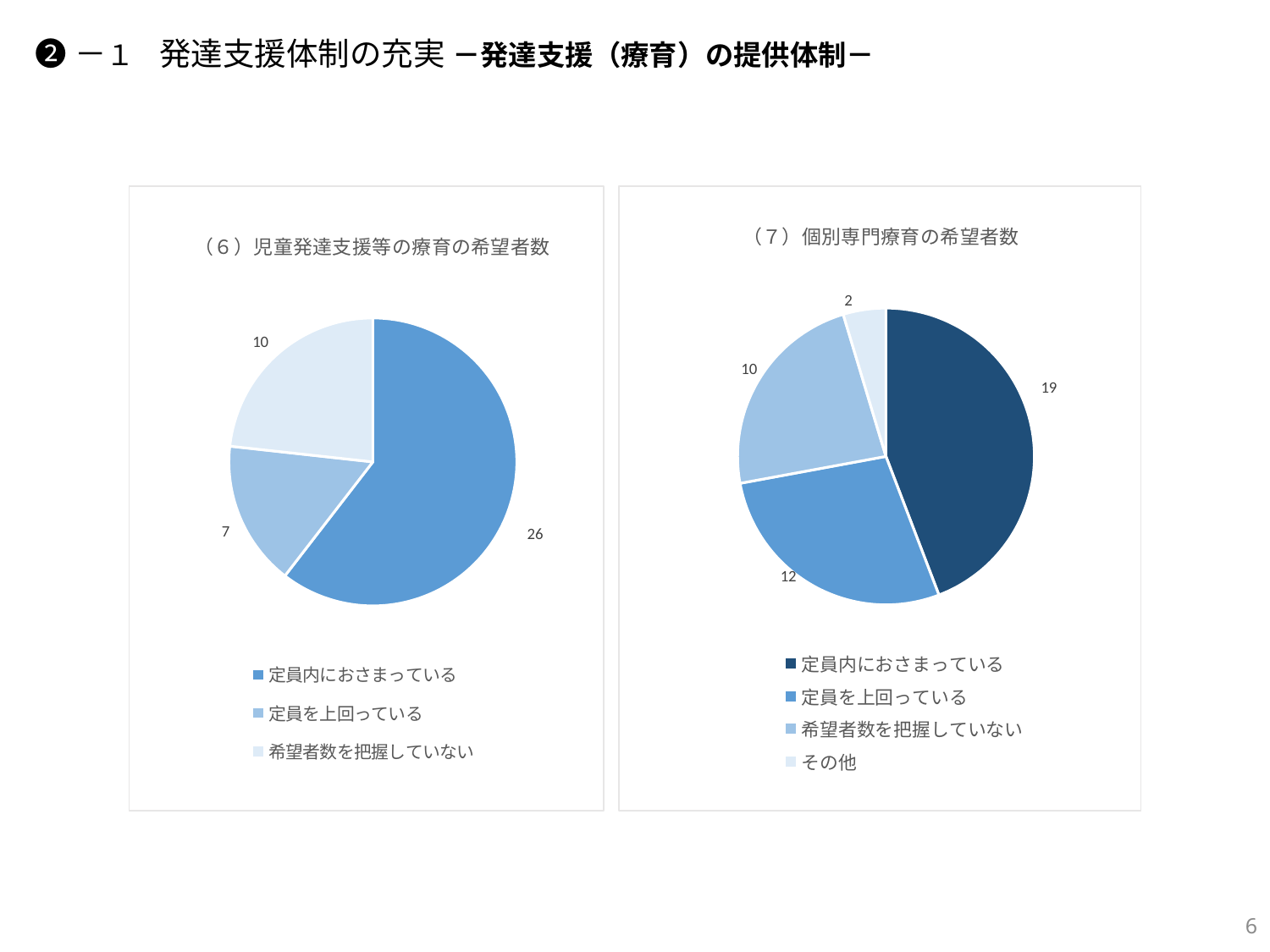
What kind of chart is the chart titled （７）個別専門療育の希望者数? Pie chart In the chart titled （６）児童発達支援等の療育の希望者数, what is the value for 定員内におさまっている? 26 How many entries does the legend of the chart titled （６）児童発達支援等の療育の希望者数 list? 3 In the chart titled （６）児童発達支援等の療育の希望者数, which category has the largest slice? 定員内におさまっている In the chart titled （６）児童発達支援等の療育の希望者数, what is the value for 定員を上回っている? 7 In the chart titled （６）児童発達支援等の療育の希望者数, what is the difference between the values for 定員内におさまっている and 希望者数を把握していない? 16 In the chart titled （７）個別専門療育の希望者数, what is the value for 希望者数を把握していない? 10 In the chart titled （６）児童発達支援等の療育の希望者数, what is the total of all slices? 43 How many categories does the chart titled （７）個別専門療育の希望者数 show? 4 In the chart titled （７）個別専門療育の希望者数, which category has the smallest slice? その他 In the chart titled （７）個別専門療育の希望者数, what is the value for その他? 2 In the chart titled （７）個別専門療育の希望者数, which is larger: 定員を上回っている or 希望者数を把握していない? 定員を上回っている